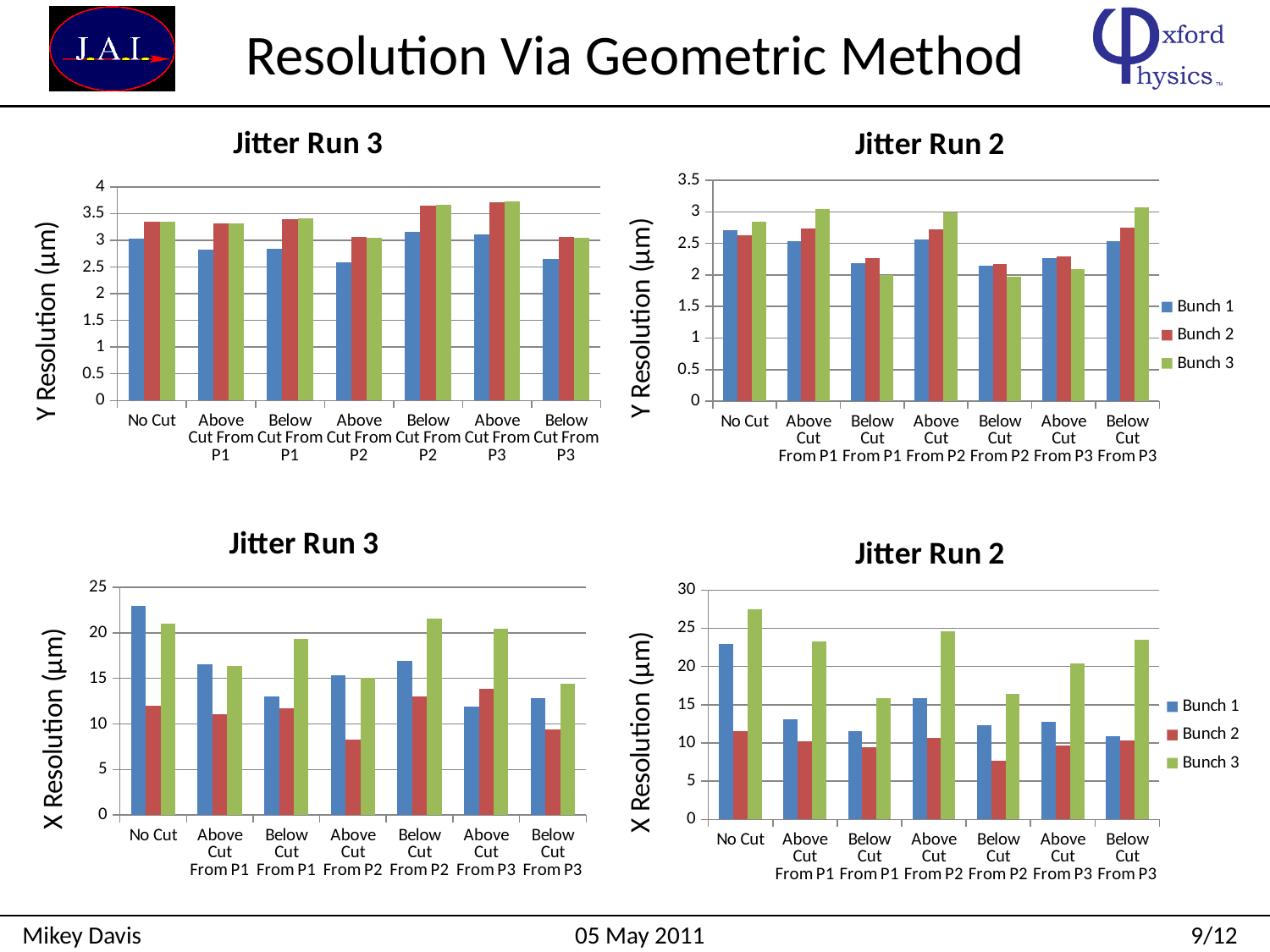
In the top-right chart (Jitter Run 2, Y Resolution), how many series does the legend list? 3 In the top-left chart (Jitter Run 3, Y Resolution), how many categories are shown on the x axis? 7 In the bottom-left chart (Jitter Run 3, X Resolution), is the Bunch 1 value for No Cut greater or less than 20? greater In the bottom-left chart (Jitter Run 3, X Resolution), which category has the highest Bunch 1 value? No Cut In the bottom-left chart (Jitter Run 3, X Resolution), which is larger for No Cut: Bunch 1 or Bunch 2? Bunch 1 In the top-left chart (Jitter Run 3, Y Resolution), is the Bunch 1 value for Above Cut From P2 greater or less than 3? less In the bottom-right chart (Jitter Run 2, X Resolution), which category has the highest Bunch 3 value? No Cut In the bottom-right chart (Jitter Run 2, X Resolution), which category has the lowest Bunch 2 value? Below Cut From P2 What kind of chart is the bottom-left chart (Jitter Run 3, X Resolution)? Bar chart In the bottom-right chart (Jitter Run 2, X Resolution), is the Bunch 3 value for No Cut greater or less than 25? greater In the top-right chart (Jitter Run 2, Y Resolution), which is larger for Below Cut From P1: Bunch 2 or Bunch 3? Bunch 2 What is the y-axis label of the bottom-left chart (Jitter Run 3)? X Resolution (μm)